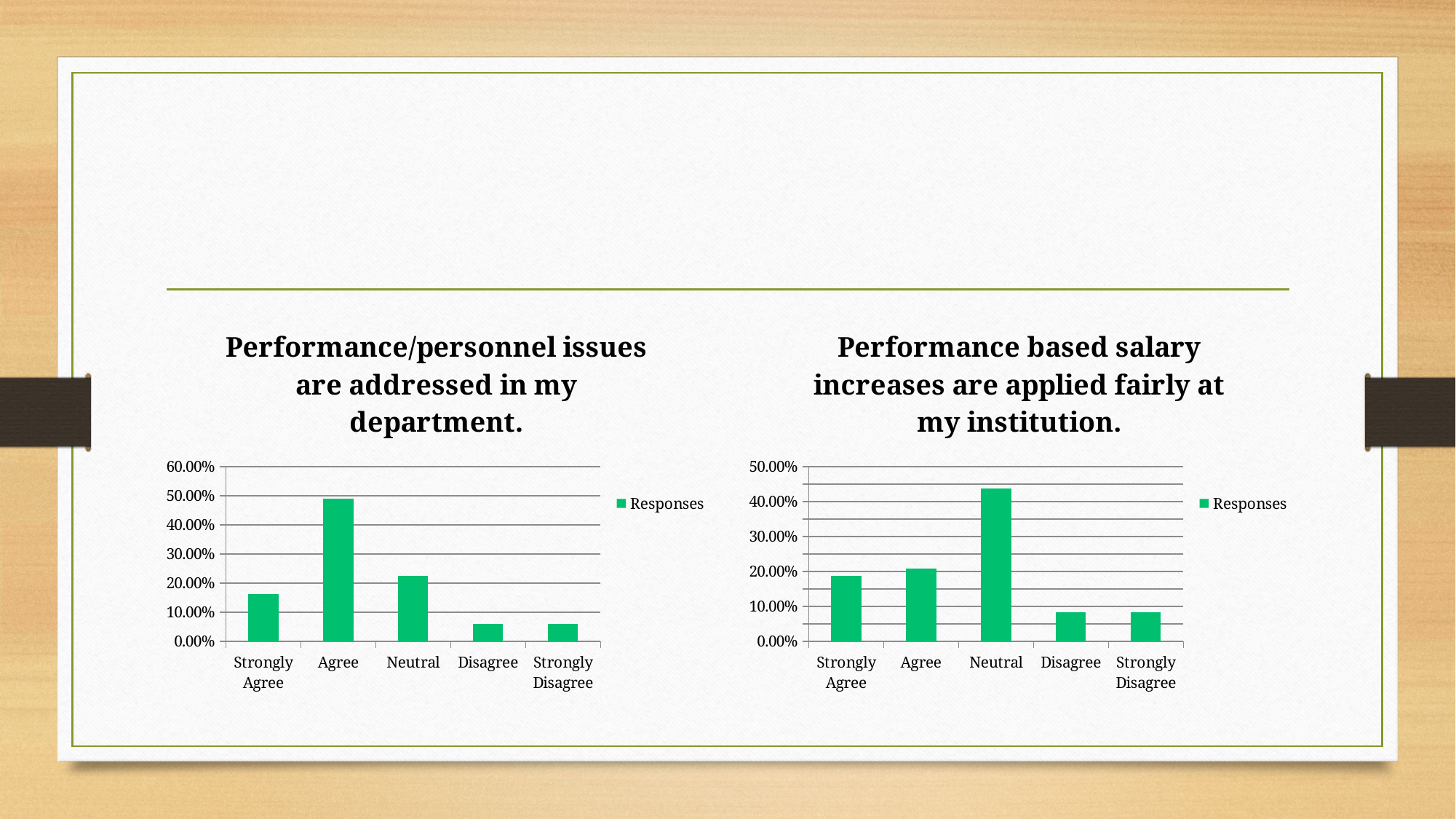
In the left chart, which is larger, the value for Neutral or the value for Strongly Agree? Neutral In the right chart, which is larger, the value for Agree or the value for Disagree? Agree What kind of chart is the chart titled "Performance based salary increases are applied fairly at my institution."? bar chart In the right chart, is the value for Disagree greater or less than 10.00%? less In the chart titled "Performance/personnel issues are addressed in my department.", which category has the highest value? Agree What is the name of the series shown in the legend of the left chart? Responses How many series does the legend of the right chart list? 1 How many categories are shown on the x axis of the left chart? 5 In the chart titled "Performance based salary increases are applied fairly at my institution.", which category has the highest value? Neutral In the left chart, is the value for Agree greater or less than 40.00%? greater In the right chart, is the value for Neutral greater or less than 40.00%? greater